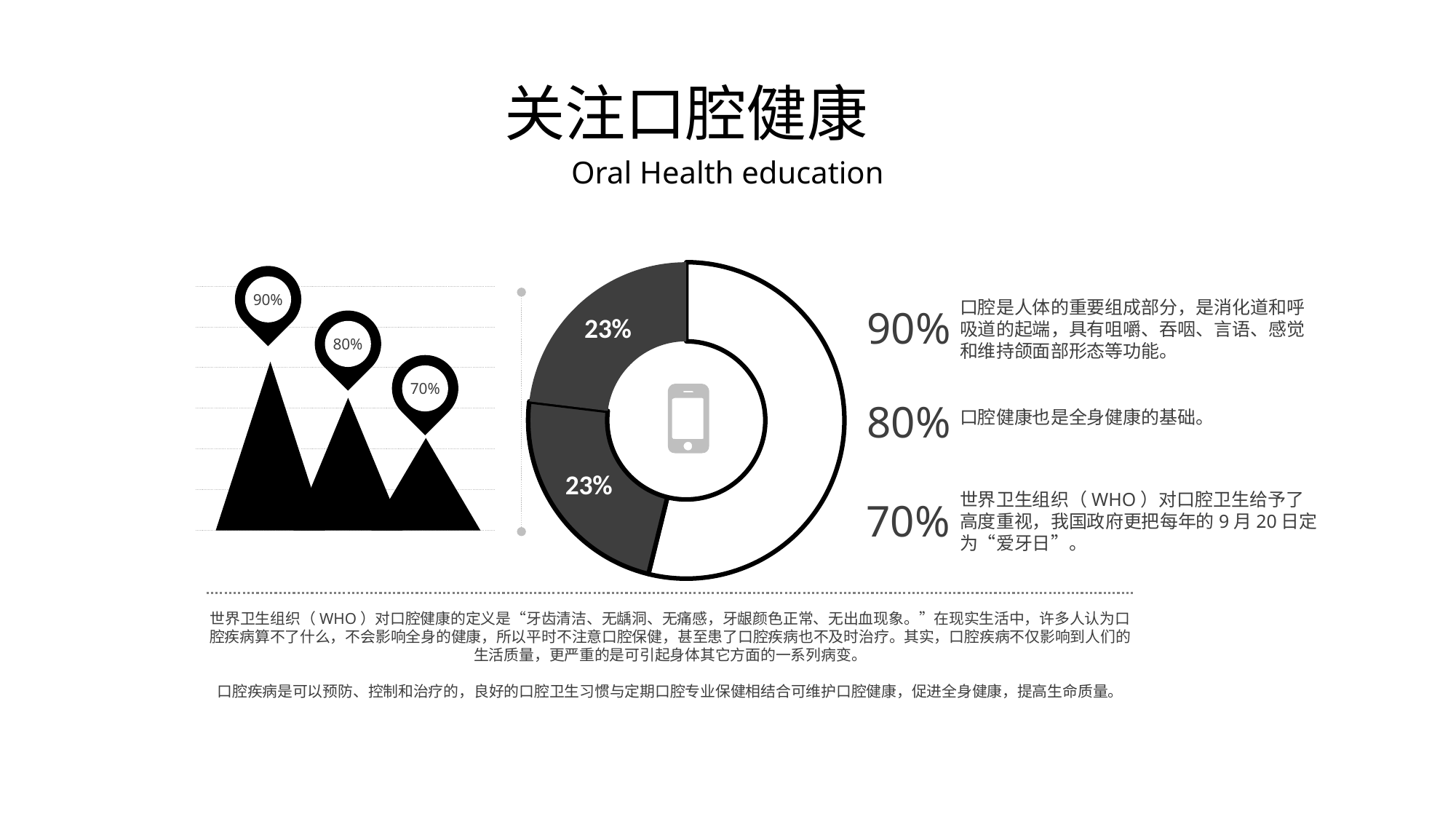
In the donut chart, how many slices carry a printed data label? 2 In the donut chart, what icon is shown in the centre hole? A mobile phone In the donut chart, what is the combined share of the two dark labelled slices? 46% In the donut chart, what value is printed on the lower-left dark slice? 23% In the mountain-peak graphic on the left, how many peaks with percentage markers are there? 3 In the mountain-peak graphic on the left, do the marker values rise or fall from left to right? fall In the mountain-peak graphic on the left, which marker shows the lowest value? 70% In the mountain-peak graphic on the left, what is the difference between the tallest peak's value and the shortest peak's value? 20% In the donut chart, what value is printed on the upper-left dark slice? 23% In the donut chart, is the white unlabelled slice larger or smaller than either dark slice? larger What kind of chart is the chart in the centre of the slide? Donut (pie) chart In the mountain-peak graphic on the left, which marker shows the highest value? 90%